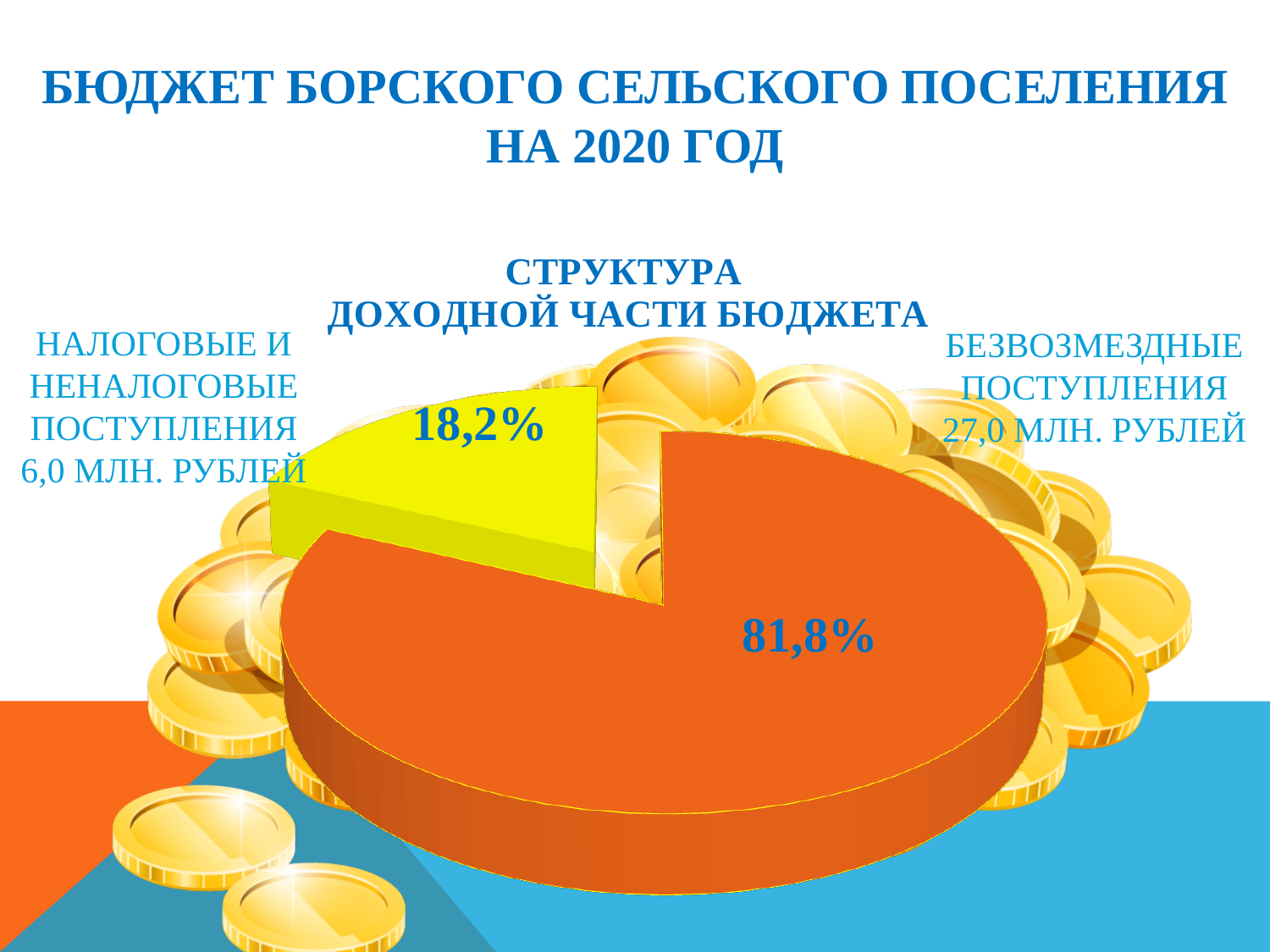
What share of the pie is labelled for БЕЗВОЗМЕЗДНЫЕ ПОСТУПЛЕНИЯ? 81,8% How many slices does the pie chart have? 2 What is the difference in percentage points between the 81,8% slice and the 18,2% slice? 63,6% What colour is the slice labelled 18,2%? yellow Which slice of the pie is the largest? БЕЗВОЗМЕЗДНЫЕ ПОСТУПЛЕНИЯ What is the title of the chart on the slide? СТРУКТУРА ДОХОДНОЙ ЧАСТИ БЮДЖЕТА What amount in million rubles is shown for НАЛОГОВЫЕ И НЕНАЛОГОВЫЕ ПОСТУПЛЕНИЯ? 6,0 МЛН. РУБЛЕЙ What amount in million rubles is shown for БЕЗВОЗМЕЗДНЫЕ ПОСТУПЛЕНИЯ? 27,0 МЛН. РУБЛЕЙ What share of the pie is labelled for НАЛОГОВЫЕ И НЕНАЛОГОВЫЕ ПОСТУПЛЕНИЯ? 18,2% Which slice of the pie is the smallest? НАЛОГОВЫЕ И НЕНАЛОГОВЫЕ ПОСТУПЛЕНИЯ What kind of chart is shown on the slide? pie chart Which is larger: the share for БЕЗВОЗМЕЗДНЫЕ ПОСТУПЛЕНИЯ or the share for НАЛОГОВЫЕ И НЕНАЛОГОВЫЕ ПОСТУПЛЕНИЯ? БЕЗВОЗМЕЗДНЫЕ ПОСТУПЛЕНИЯ